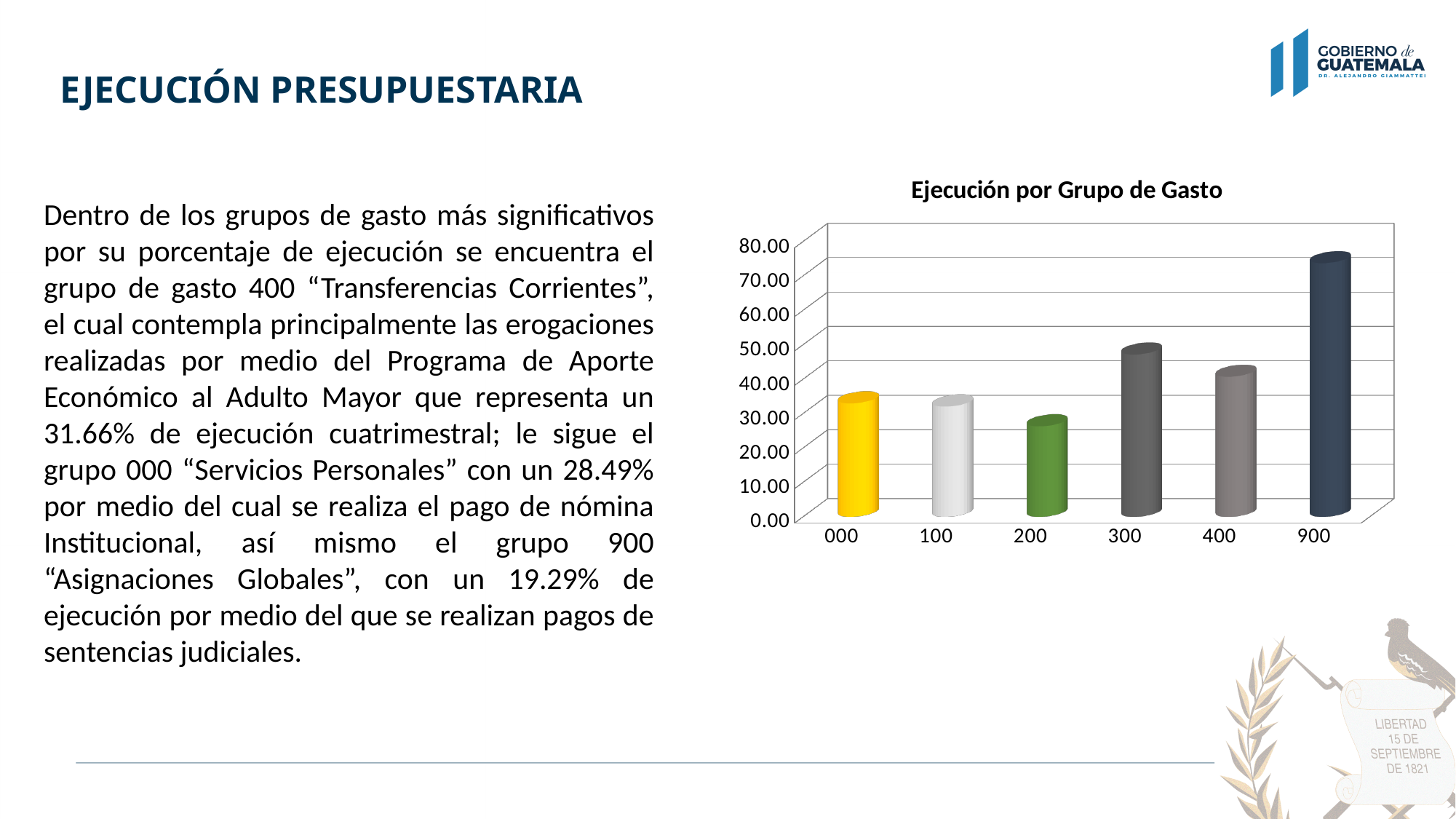
What kind of chart is shown on the slide? bar chart Which has a larger value in the chart, group 200 or group 000? 000 Which has a larger value in the chart, group 300 or group 400? 300 What colour is the bar for group 000 in the chart? yellow Which has a larger value in the chart, group 900 or group 300? 900 Which expense group has the lowest value in the chart? 200 How many expense groups (categories) are plotted on the x axis of the chart? 6 Is the value for group 300 greater or less than 40.00? greater Is the value for group 200 greater or less than 30.00? less Which expense group has the highest value in the chart? 900 What is the title of the chart? Ejecución por Grupo de Gasto Is the value for group 900 greater or less than 60.00? greater